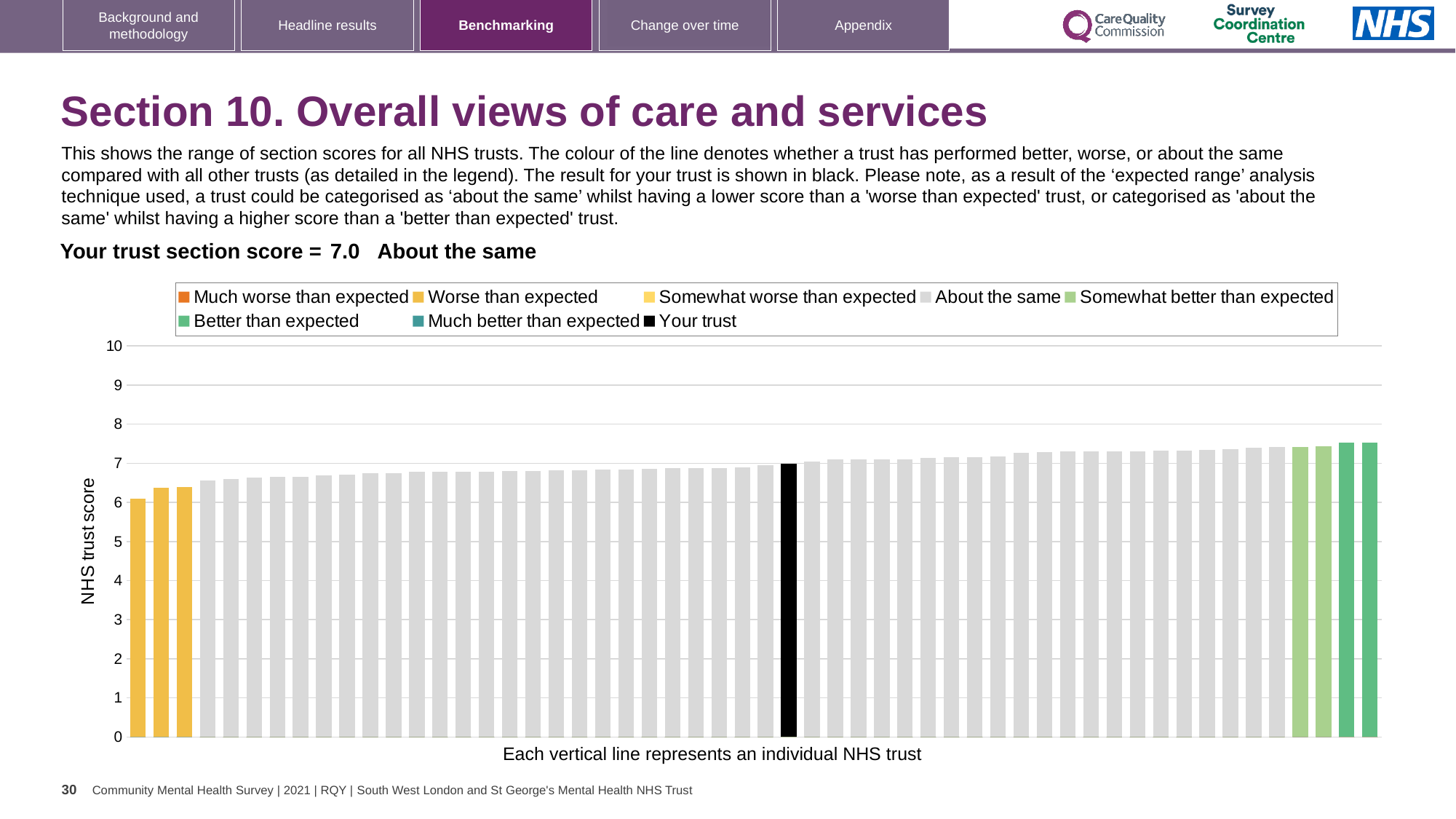
What is the title of the vertical axis? NHS trust score Which performance category is your trust placed in for this section? About the same What is the section score for your trust shown on the slide? 7.0 Is the value for the leftmost bar greater or less than 7? less Which is larger, the leftmost bar or the rightmost bar? the rightmost bar Do the bar values rise or fall moving from left to right along the x axis? rise How many entries does the chart legend list? 8 What kind of chart is shown on the slide? bar chart Which legend category do the highest bars on the chart belong to? Better than expected Is the value for the rightmost bar greater or less than 7? greater Which legend category do the lowest bars on the chart belong to? Worse than expected Is the value for the black 'Your trust' bar greater or less than 5? greater